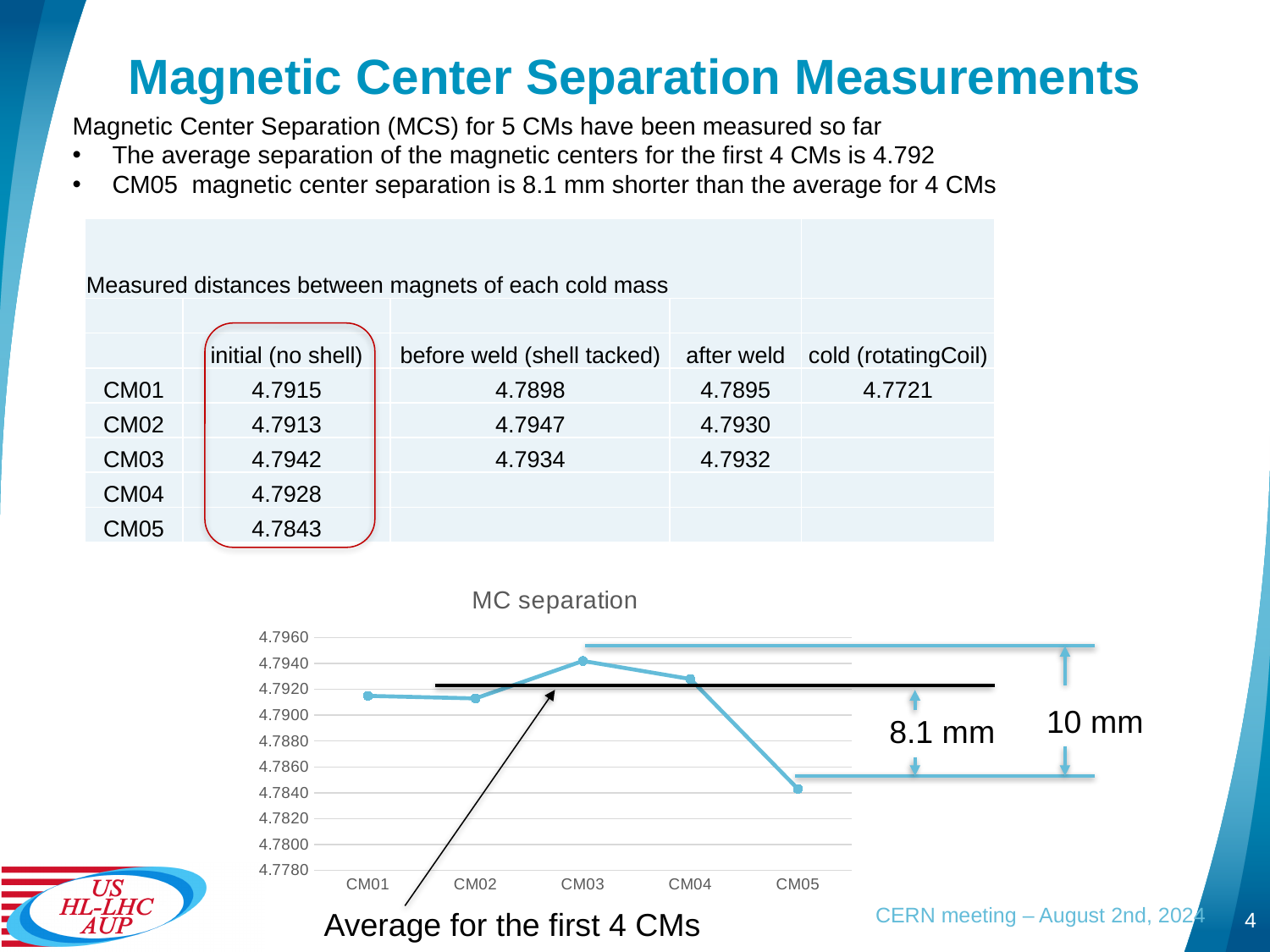
Which cold mass has the highest MC separation value on the chart? CM03 Is the MC separation value for CM04 greater or less than 4.7900? greater What is the title of the chart on the slide? MC separation Does the MC separation value rise or fall from CM04 to CM05? fall Which cold mass has the lowest MC separation value on the chart? CM05 Is the MC separation value for CM03 greater or less than 4.7920? greater What kind of chart is the "MC separation" chart? line chart On the MC separation chart, which has the larger value, CM03 or CM05? CM03 Is the MC separation value for CM05 greater or less than 4.7860? less How many cold masses (data points) are plotted on the MC separation chart? 5 According to the annotation on the chart, how much shorter is the CM05 separation than the average for the first 4 CMs? 8.1 mm